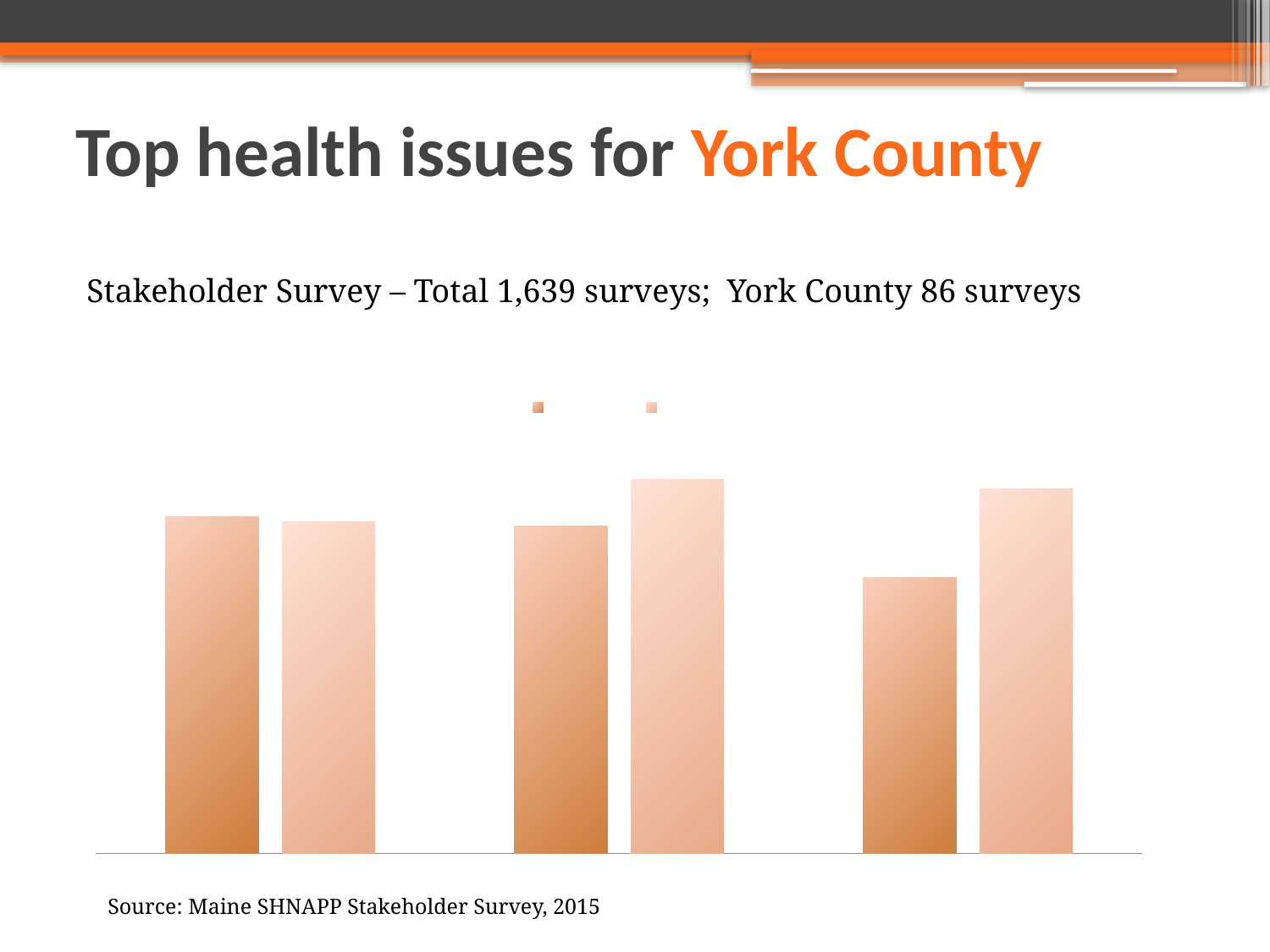
In the middle group of bars, is the darker bar or the lighter bar taller? the lighter bar Which group of bars contains the tallest bar on the chart? the middle group In the rightmost group of bars, is the darker bar or the lighter bar taller? the lighter bar How many bars are plotted in total on the chart? 6 Which group of bars contains the shortest bar on the chart? the rightmost group How many groups of bars does the chart show? 3 How many series does the chart's legend list? 2 What kind of chart is shown on the slide? bar chart